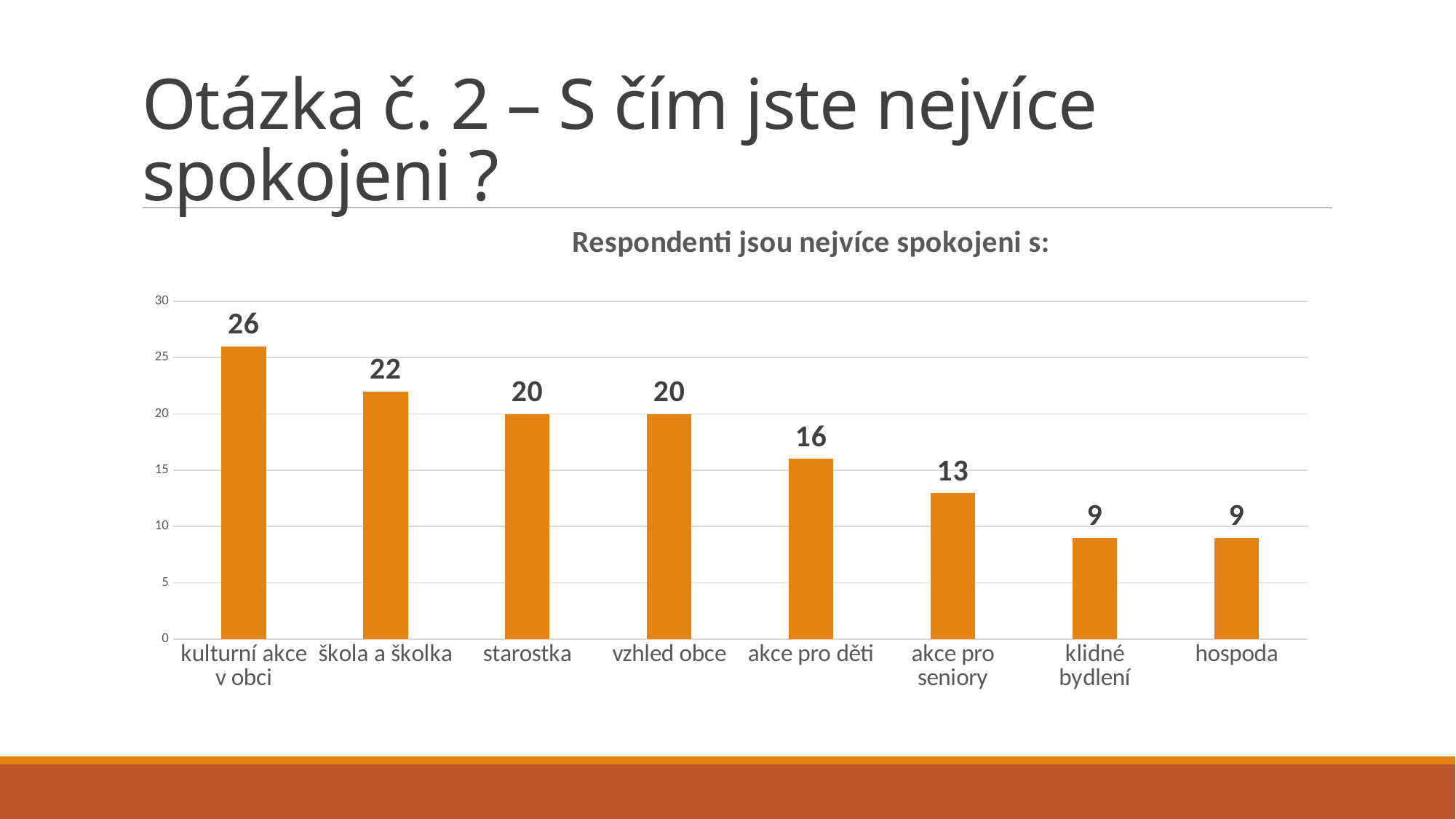
Which category has the highest value? kulturní akce v obci What is the value for 'kulturní akce v obci'? 26 Do the values rise or fall from left to right along the x axis? fall Which is larger, the value for 'škola a školka' or the value for 'starostka'? škola a školka How many categories are shown in the chart? 8 What is the difference between the values for 'kulturní akce v obci' and 'akce pro děti'? 10 What is the value for 'škola a školka'? 22 What colour are the bars in the chart? orange What is the value for 'akce pro seniory'? 13 Is the value for 'akce pro děti' greater or less than 15? greater What is the title of the chart? Respondenti jsou nejvíce spokojeni s: What kind of chart is shown on the slide? bar chart